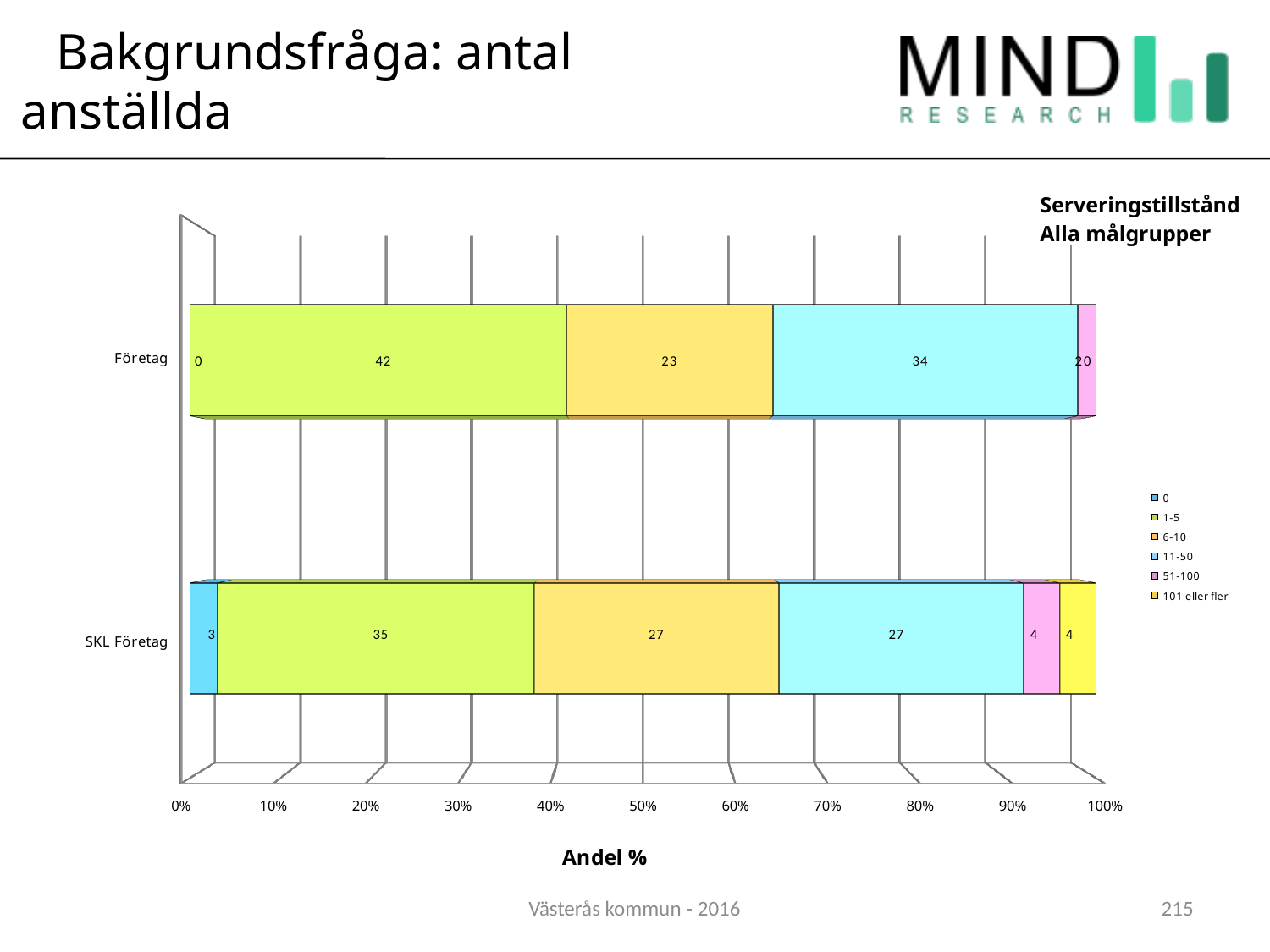
What is the value of the 51-100 series for SKL Företag? 4 Which category has the larger value for the 6-10 series, Företag or SKL Företag? SKL Företag How many series does the legend list? 6 What is the label of the x axis? Andel % How many categories are plotted on the y axis of the chart? 2 What is the value of the 0 series for SKL Företag? 3 What is the value of the 6-10 series for SKL Företag? 27 What is the value of the 11-50 series for Företag? 34 Which series has the highest value for Företag? 1-5 What is the difference between the 1-5 values for Företag and SKL Företag? 7 What kind of chart is shown on the slide? stacked bar chart What is the value of the 1-5 series for Företag? 42